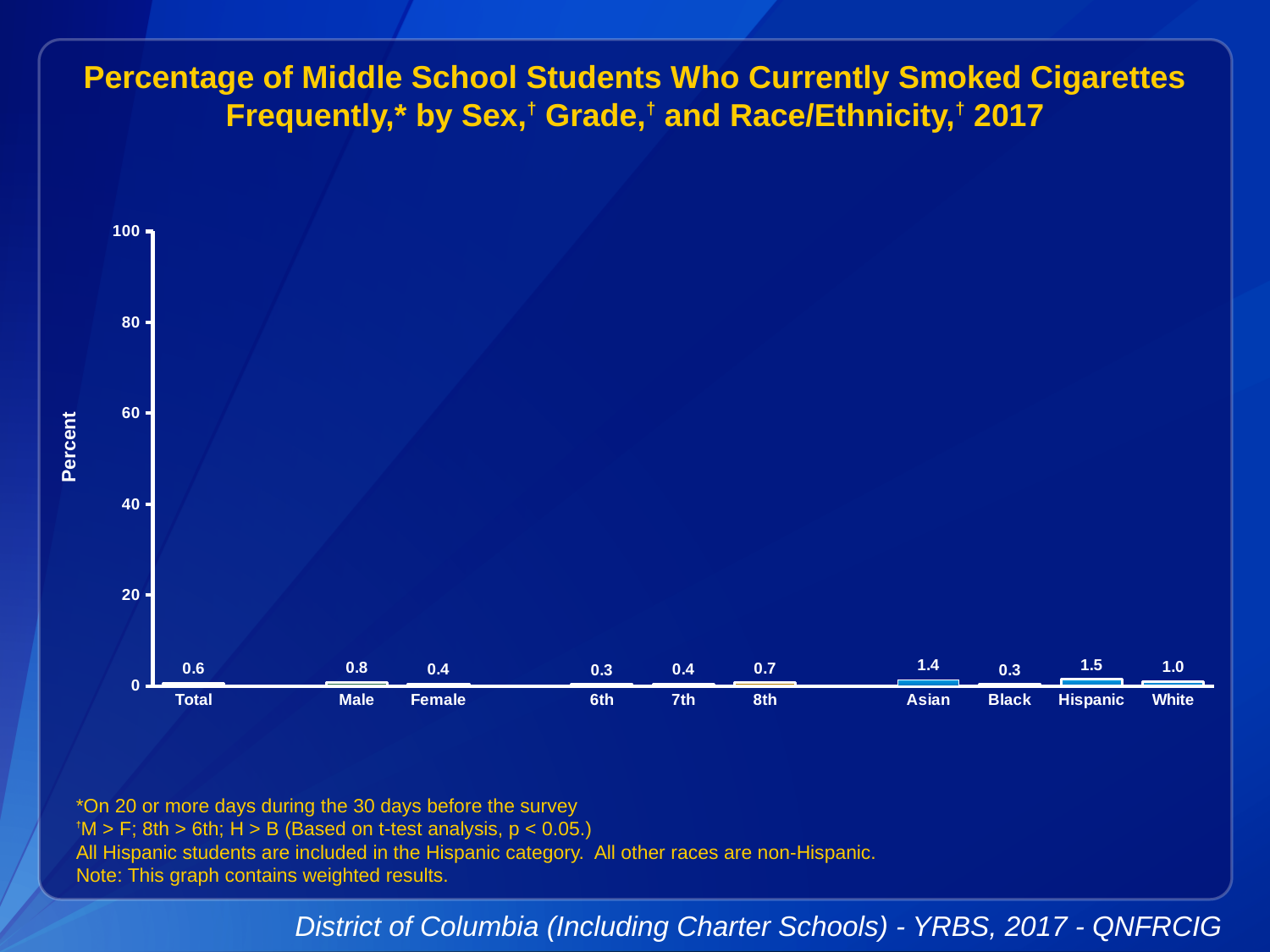
Is the value for White greater or less than 20? less Which category has the highest value? Hispanic What kind of chart is shown on the slide? bar chart How many categories are shown on the x axis? 10 What is the value for 8th grade? 0.7 What is the value for Hispanic? 1.5 What is the difference between the values for Male and Female? 0.4 Which is larger, the value for 8th grade or the value for 6th grade? 8th What is the value for Male? 0.8 What is the difference between the values for Asian and Black? 1.1 What is the value for Total? 0.6 What is the label of the y axis? Percent